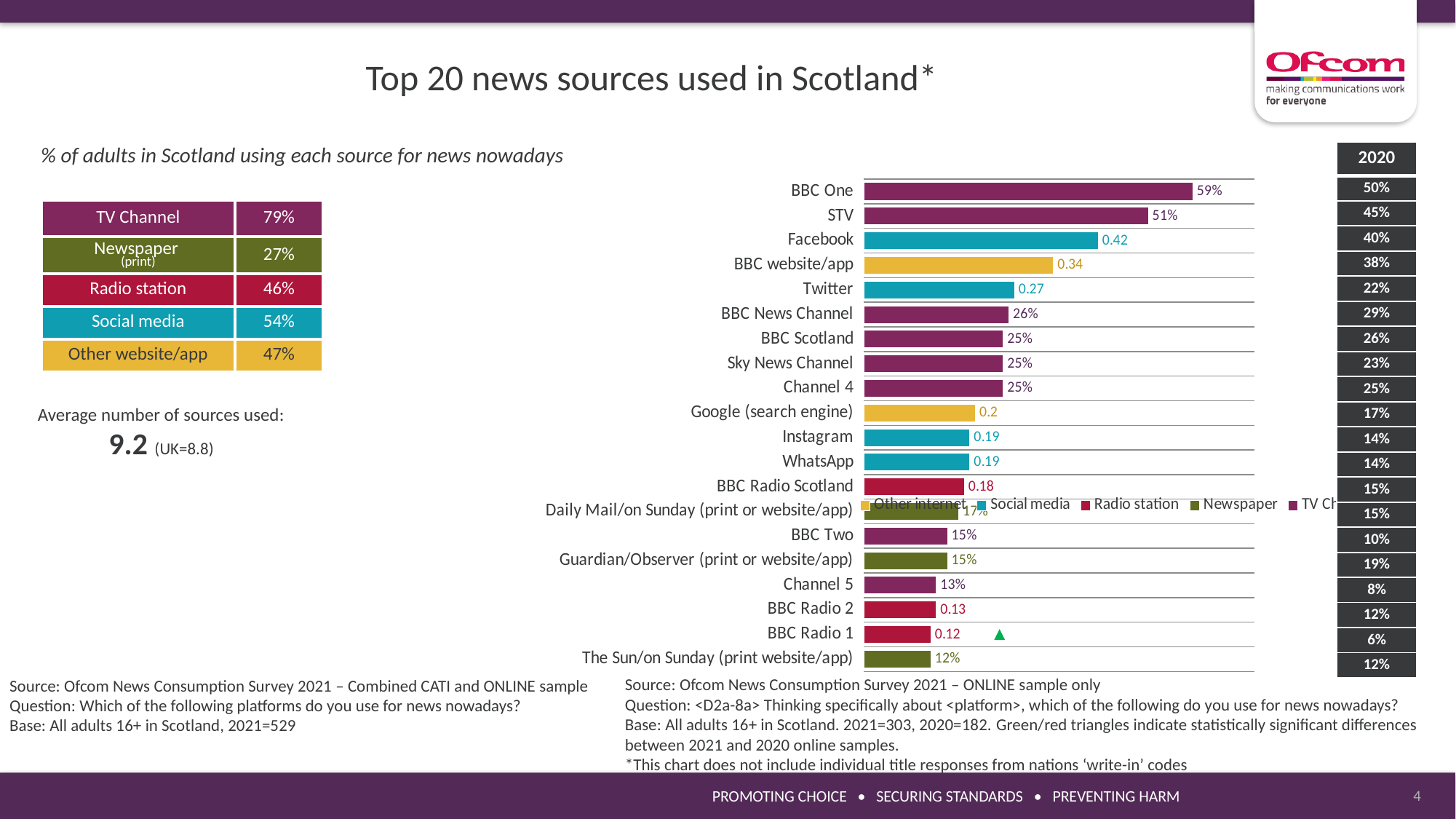
What is the value shown for Channel 5? 13% Which news source has the highest value in the chart? BBC One What is the difference between the values for BBC One and STV? 8% What is the value shown for Twitter? 0.27 What is the value shown for Facebook? 0.42 What kind of chart is used to show the top 20 news sources? Bar chart What is the value shown for Google (search engine)? 0.2 Which legend entry is shown in yellow? Other internet Which has a larger value, STV or BBC News Channel? STV What is the value shown for BBC One? 59% How many news sources are plotted in the chart? 20 How many series does the chart legend list? 5